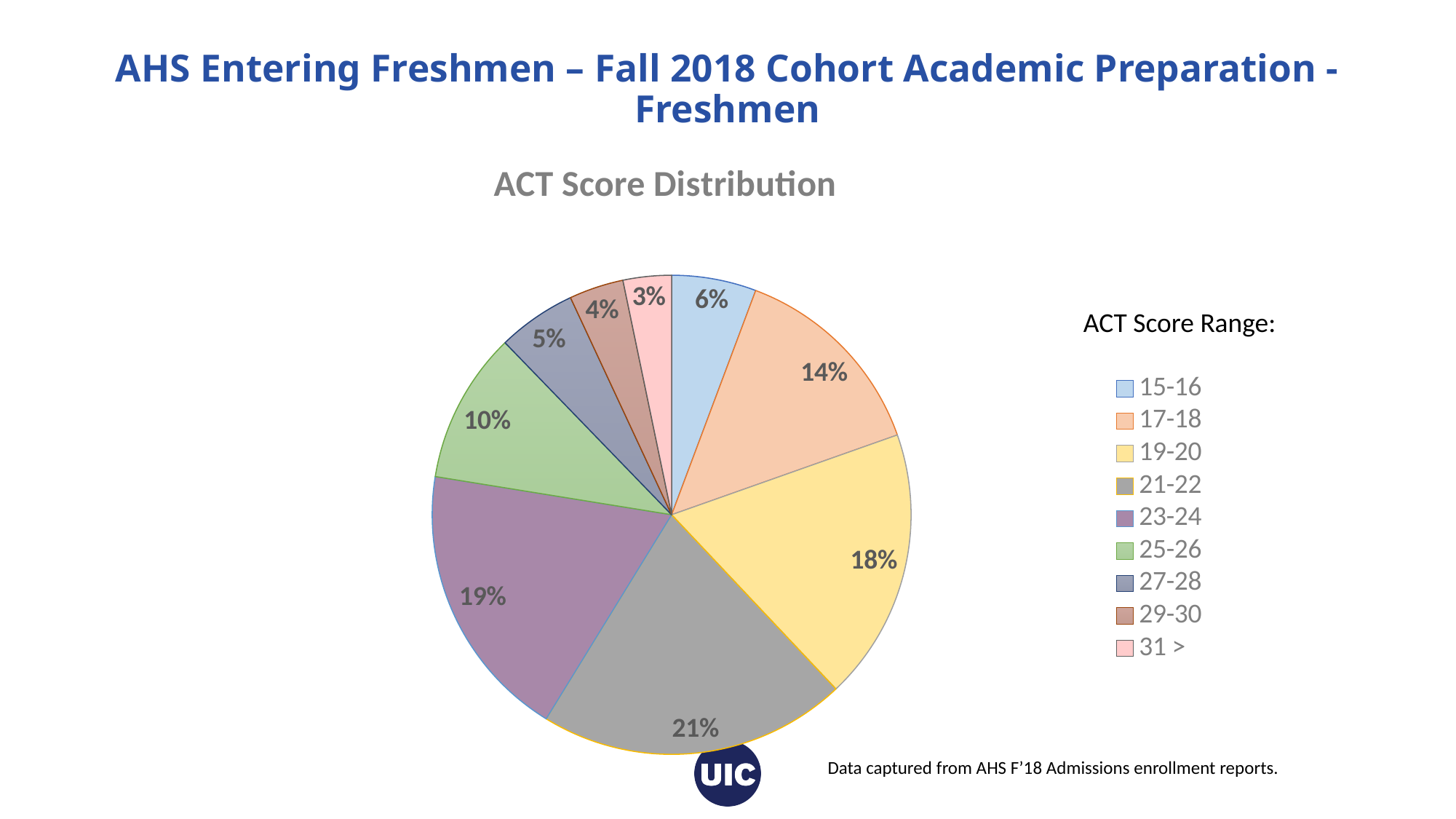
How many ACT score ranges are shown in the pie chart? 9 What kind of chart is shown on the slide? Pie chart What share of the pie does the 21-22 ACT score range hold? 21% What percentage is shown for the 15-16 ACT score range? 6% What percentage is shown for the 23-24 ACT score range? 19% What is the difference in percentage points between the 19-20 and 17-18 ranges? 4 What is the combined percentage of the 29-30 and 31 > ranges? 7% Which ACT score range has the smallest slice of the pie? 31 > What is the title of the chart? ACT Score Distribution Which ACT score range has the largest slice of the pie? 21-22 Which is larger, the share for 25-26 or the share for 27-28? 25-26 What is the heading of the legend? ACT Score Range: